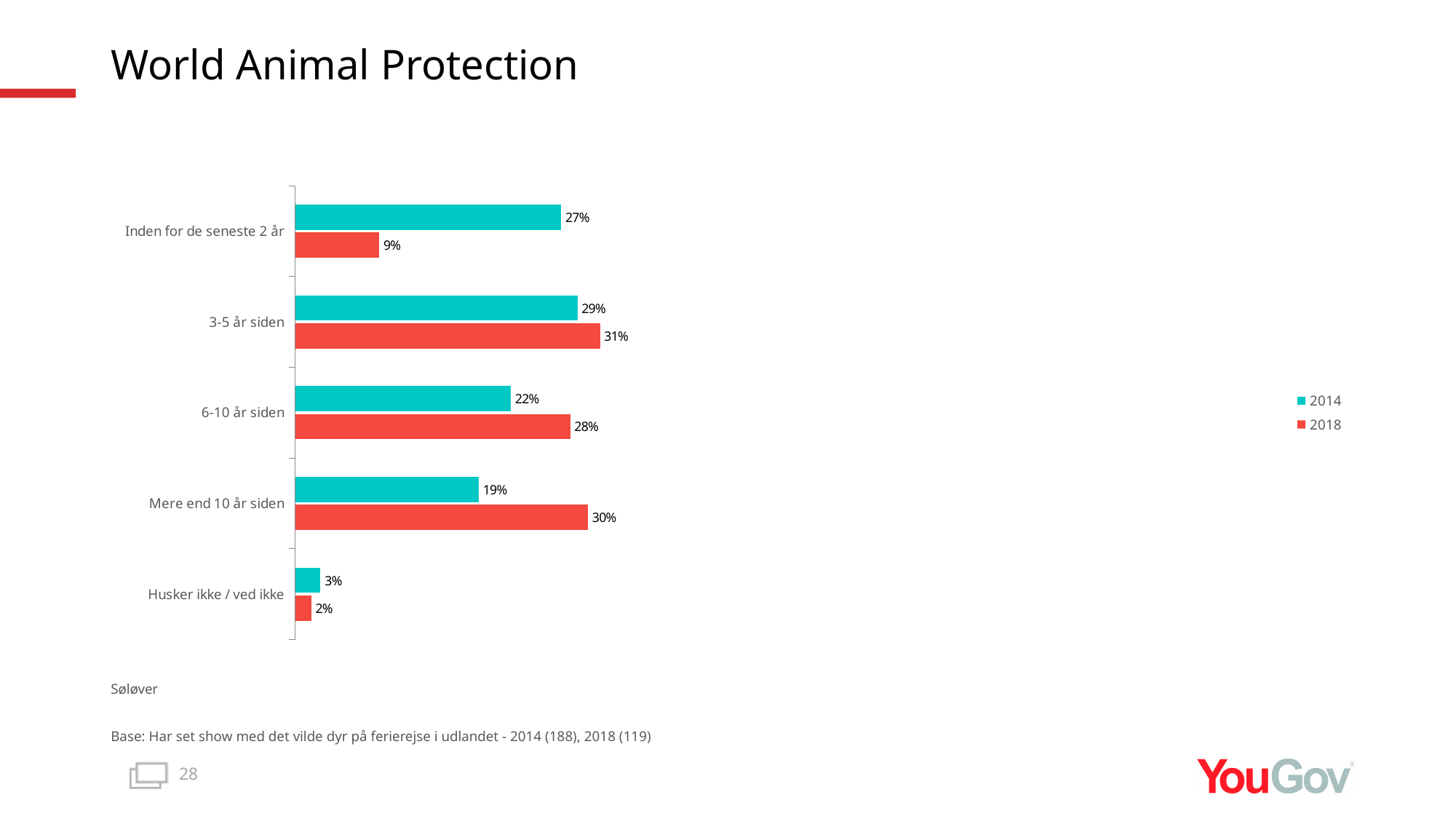
What is the difference between the 2018 and 2014 values for "Mere end 10 år siden"? 11% What kind of chart is shown on the slide? Bar chart Which colour represents the 2018 series? Red What is the difference between the 2014 and 2018 values for "Inden for de seneste 2 år"? 18% What is the 2018 value for "Mere end 10 år siden"? 30% What is the 2018 value for "6-10 år siden"? 28% Which category has the lowest 2014 value? Husker ikke / ved ikke How many series does the legend list? 2 How many categories are shown on the chart? 5 Which category has the highest 2018 value? 3-5 år siden Which is larger for "Mere end 10 år siden": the 2014 value or the 2018 value? 2018 What is the 2014 value for "Inden for de seneste 2 år"? 27%